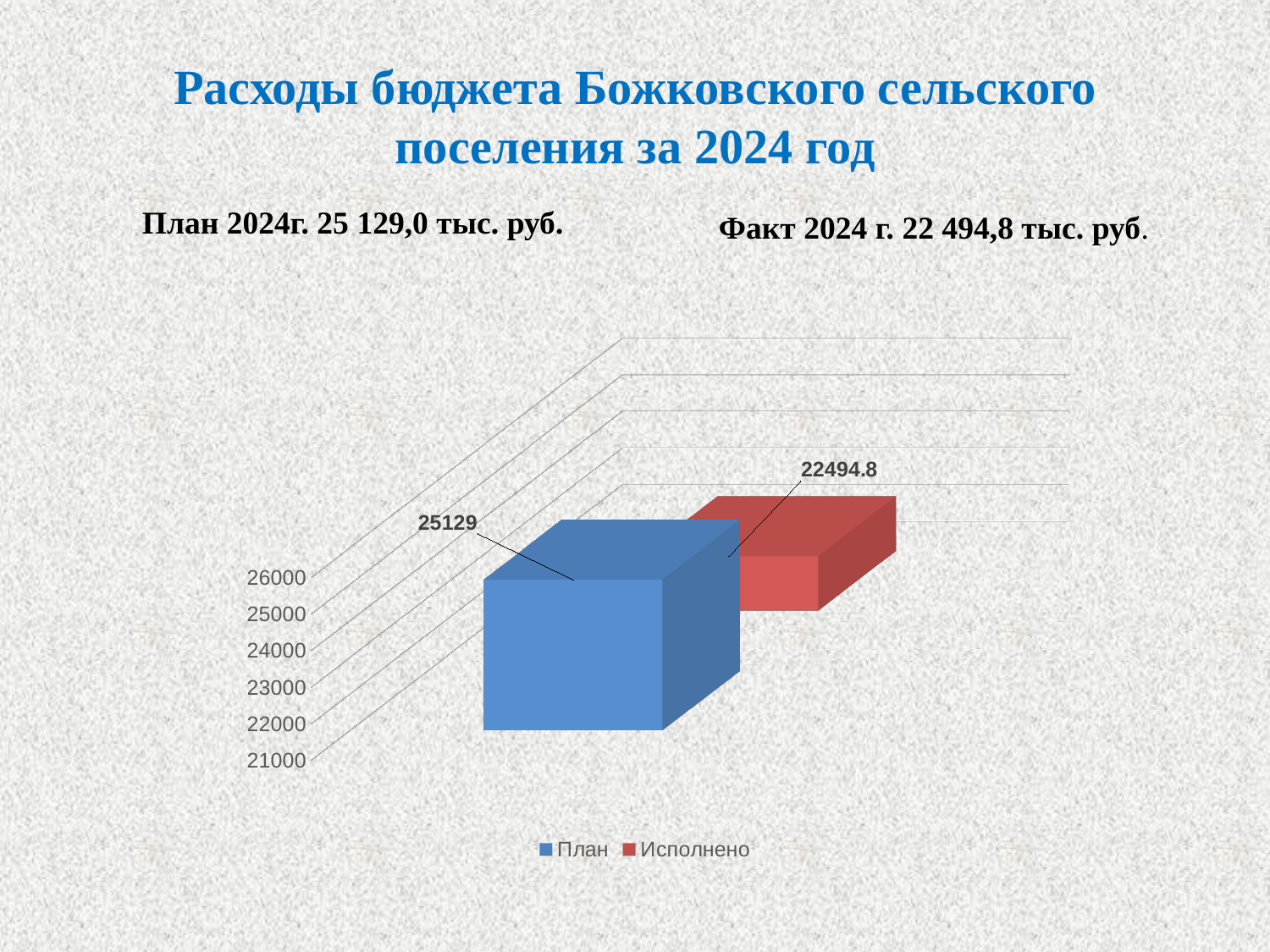
How many bars are plotted on the chart? 2 What colour is the Исполнено bar? red Which series has the higher value, План or Исполнено? План Which series has the lowest value on the chart? Исполнено What is the highest value shown on the vertical axis? 26000 Is the value for Исполнено greater or less than 23000? less What is the value of the План bar? 25129 How many series does the legend list? 2 What is the value of the Исполнено bar? 22494.8 What is the difference between the План value and the Исполнено value? 2634.2 What kind of chart is shown on the slide? bar chart Is the value for План greater or less than 24000? greater